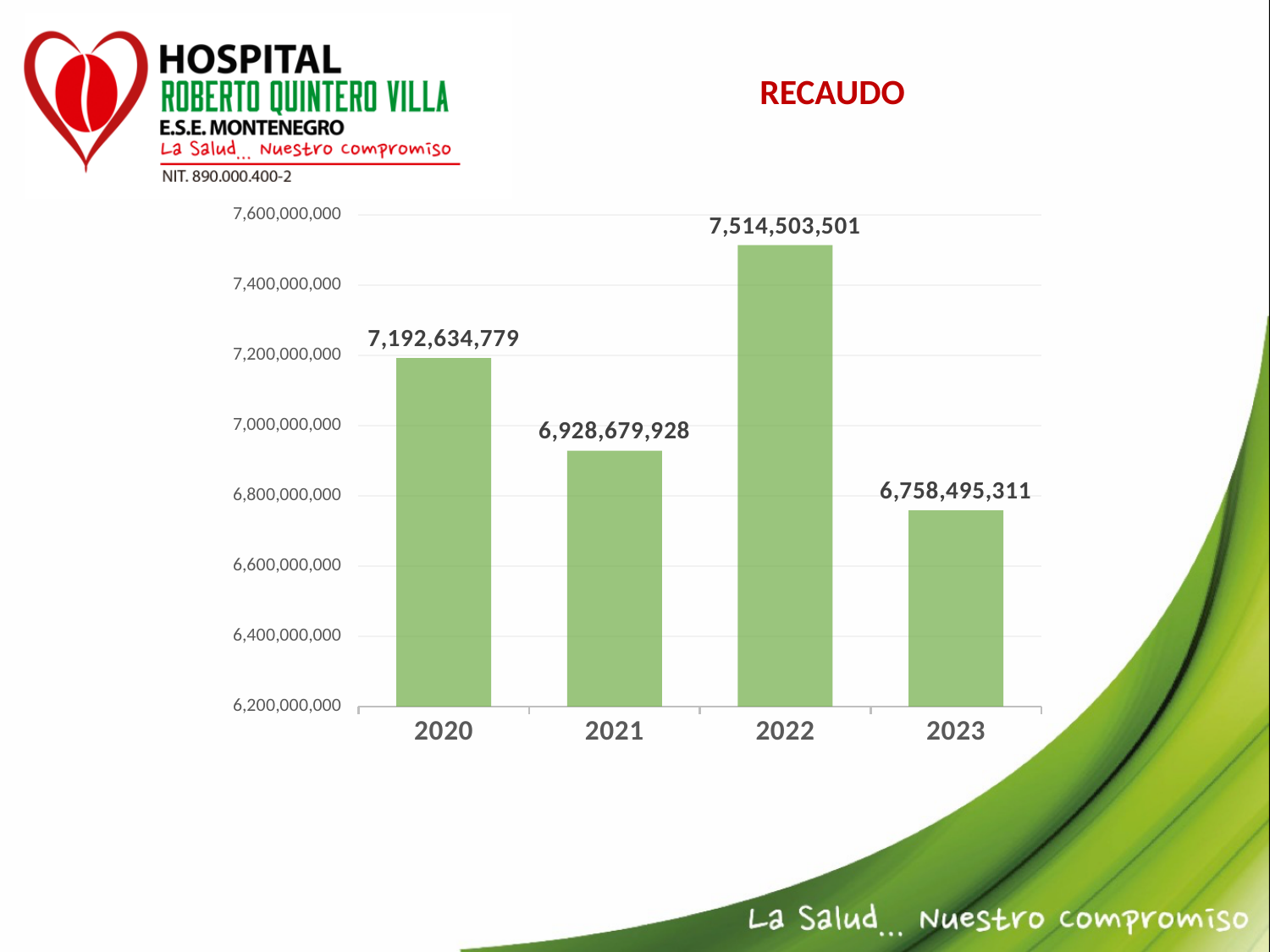
What is the value for 2022? 7,514,503,501 What is the title of the chart? RECAUDO Which is larger, the value for 2021 or the value for 2023? 2021 What is the value for 2021? 6,928,679,928 Which year has the lowest value? 2023 What is the value for 2023? 6,758,495,311 Is the value for 2023 greater or less than 6,800,000,000? less What is the difference between the values for 2020 and 2021? 263,954,851 What is the difference between the values for 2022 and 2020? 321,868,722 What is the value for 2020? 7,192,634,779 How many years are shown on the chart? 4 Which year has the highest value? 2022